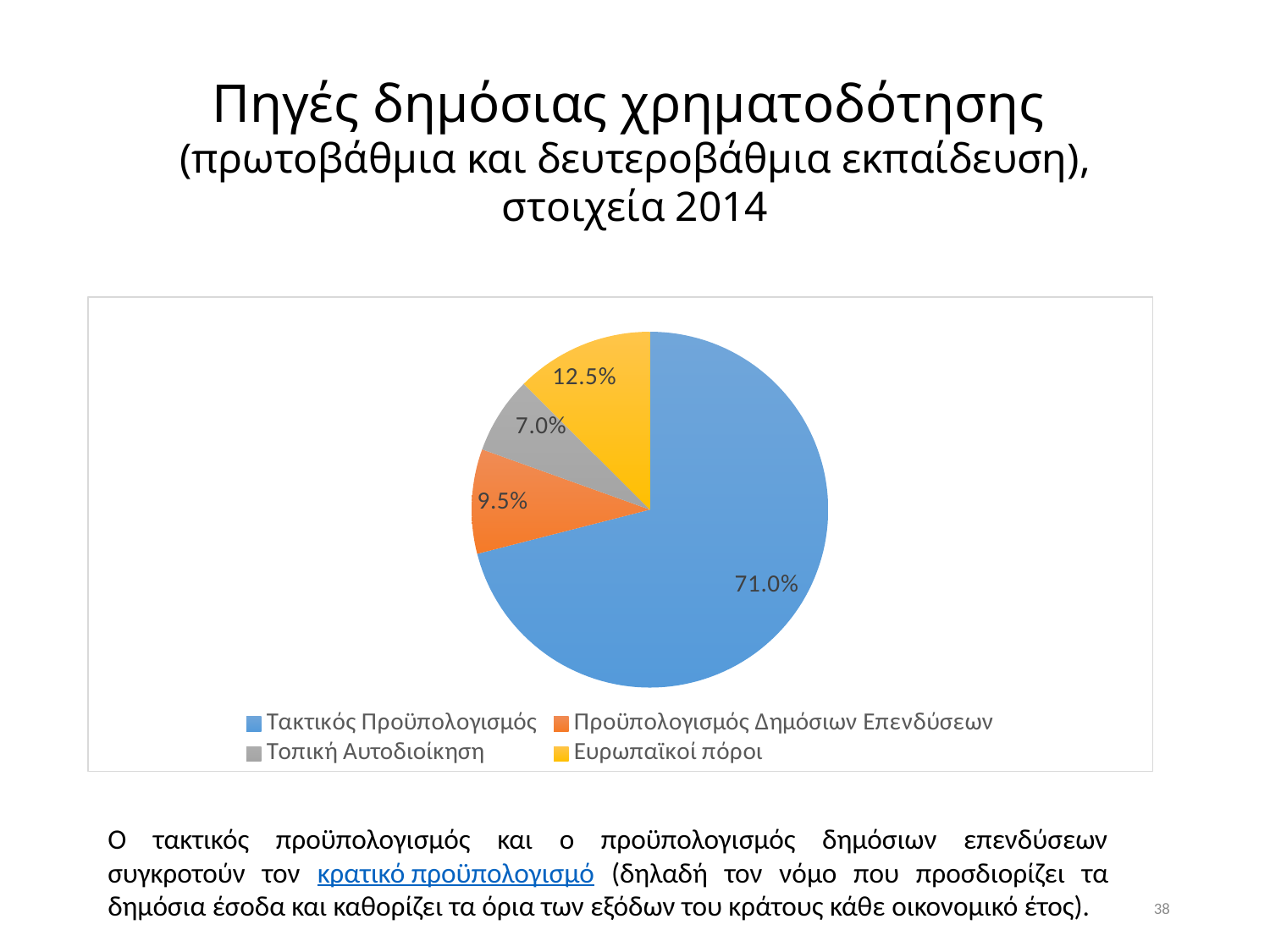
What colour is the slice for Τακτικός Προϋπολογισμός? Blue Which is larger, the share for Ευρωπαϊκοί πόροι or the share for Τοπική Αυτοδιοίκηση? Ευρωπαϊκοί πόροι What is the difference in percentage points between Ευρωπαϊκοί πόροι and Προϋπολογισμός Δημόσιων Επενδύσεων? 3.0 percentage points What is the value shown for Τοπική Αυτοδιοίκηση? 7.0% What is the value shown for Προϋπολογισμός Δημόσιων Επενδύσεων? 9.5% How many categories are shown in the pie chart? 4 What year do the data on the slide refer to, according to the title? 2014 What share of the pie does Τακτικός Προϋπολογισμός represent? 71.0% What kind of chart is shown on the slide? Pie chart What is the value shown for Ευρωπαϊκοί πόροι? 12.5% Which category has the smallest slice of the pie? Τοπική Αυτοδιοίκηση Which category has the largest slice of the pie? Τακτικός Προϋπολογισμός